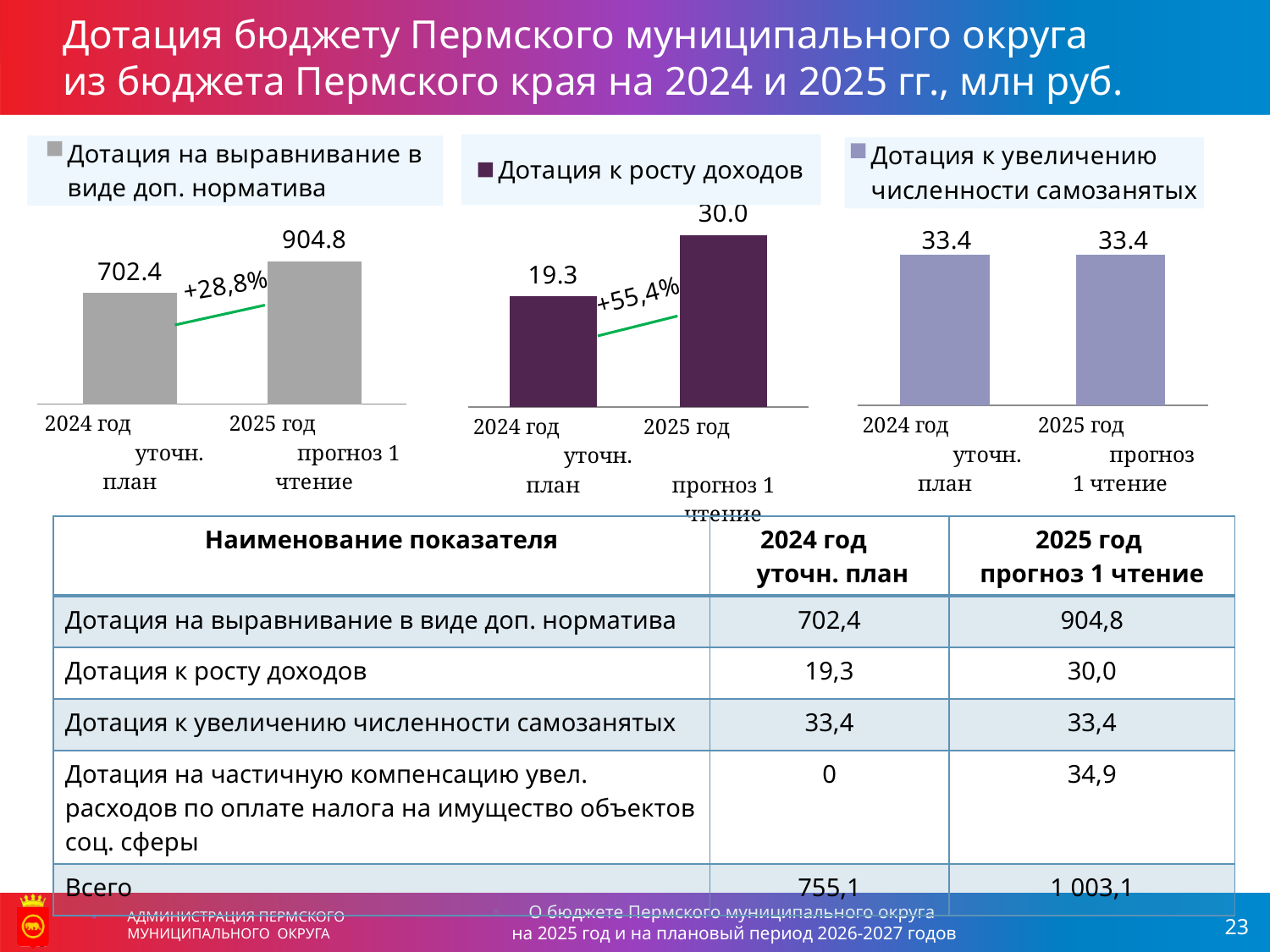
In the right chart (Дотация к увеличению численности самозанятых), what is the value for 2025 год прогноз 1 чтение? 33.4 In the middle chart (Дотация к росту доходов), what is the difference between the 2025 and 2024 values? 10.7 In the left chart (Дотация на выравнивание в виде доп. нормативa), what is the value for 2024 год уточн. план? 702.4 In the left chart (Дотация на выравнивание в виде доп. норматива), what is the value for 2025 год прогноз 1 чтение? 904.8 In the middle chart (Дотация к росту доходов), what is the value for 2025 год прогноз 1 чтение? 30.0 How many bars are plotted in the left chart (Дотация на выравнивание в виде доп. норматива)? 2 What type of chart is the middle chart (Дотация к росту доходов)? bar chart In the left chart (Дотация на выравнивание в виде доп. норматива), what percentage change is shown between 2024 and 2025? +28,8% In the middle chart (Дотация к росту доходов), what is the value for 2024 год уточн. план? 19.3 In the left chart (Дотация на выравнивание в виде доп. норматива), which year has the higher value? 2025 год прогноз 1 чтение In the right chart (Дотация к увеличению численности самозанятых), do the values rise, fall or stay the same from 2024 to 2025? stay the same In the middle chart (Дотация к росту доходов), what percentage change is shown between 2024 and 2025? +55,4%